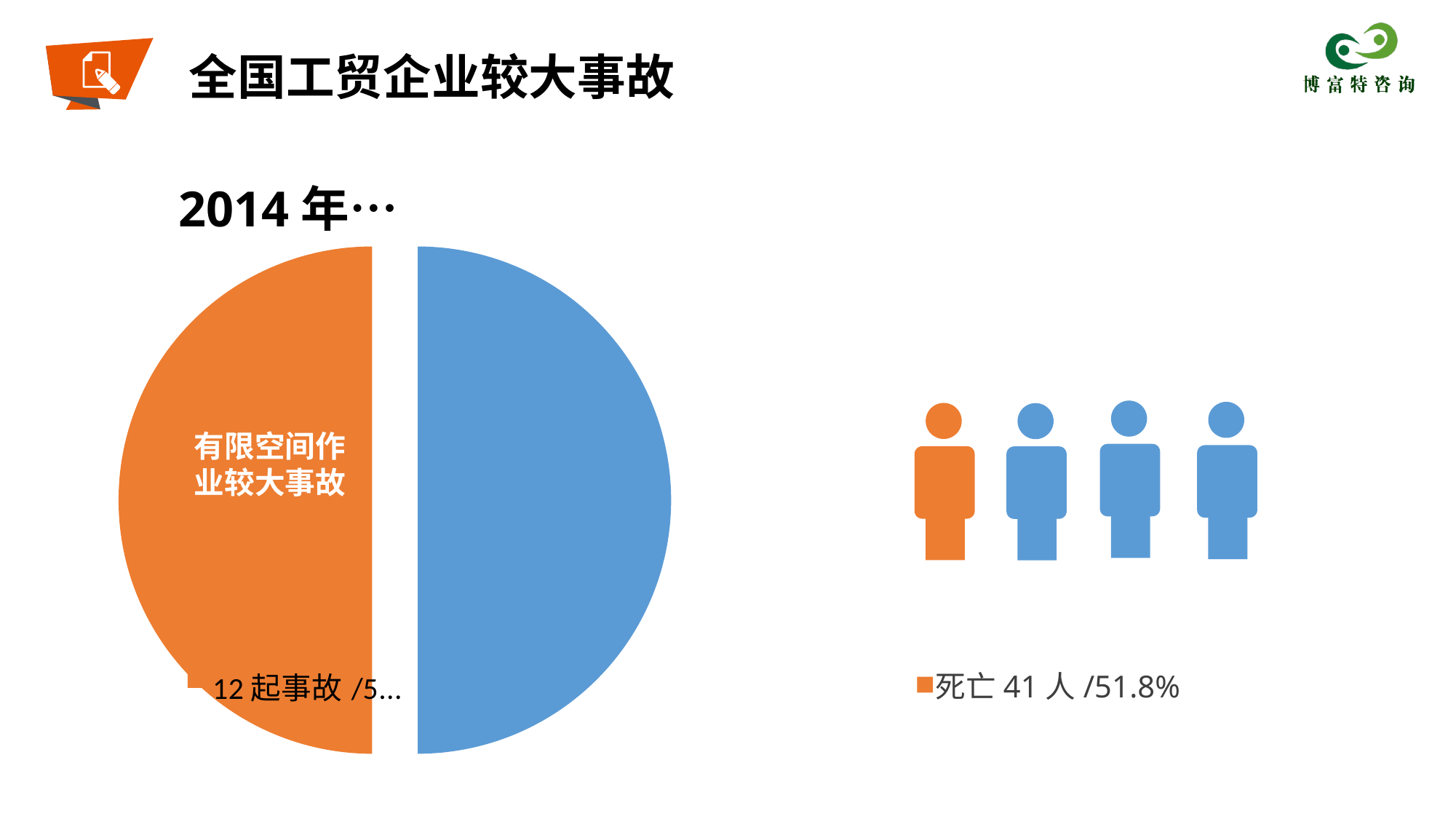
In the pictogram on the right, how many deaths (死亡) does the legend state? 41 人 In the pictogram on the right, how many of the person icons are orange? 1 In the pictogram on the right, how many person icons are shown? 4 In the pie chart on the left, which slice carries the label 有限空间作业较大事故? the orange slice According to the legend of the pie chart on the left, how many accidents (起事故) are stated? 12 How many slices does the pie chart on the left have? 2 In the pictogram on the right, what percentage is given in the legend for 死亡 41 人? 51.8% What kind of chart is shown on the left of the slide? pie chart What year is shown in the title of the pie chart on the left? 2014